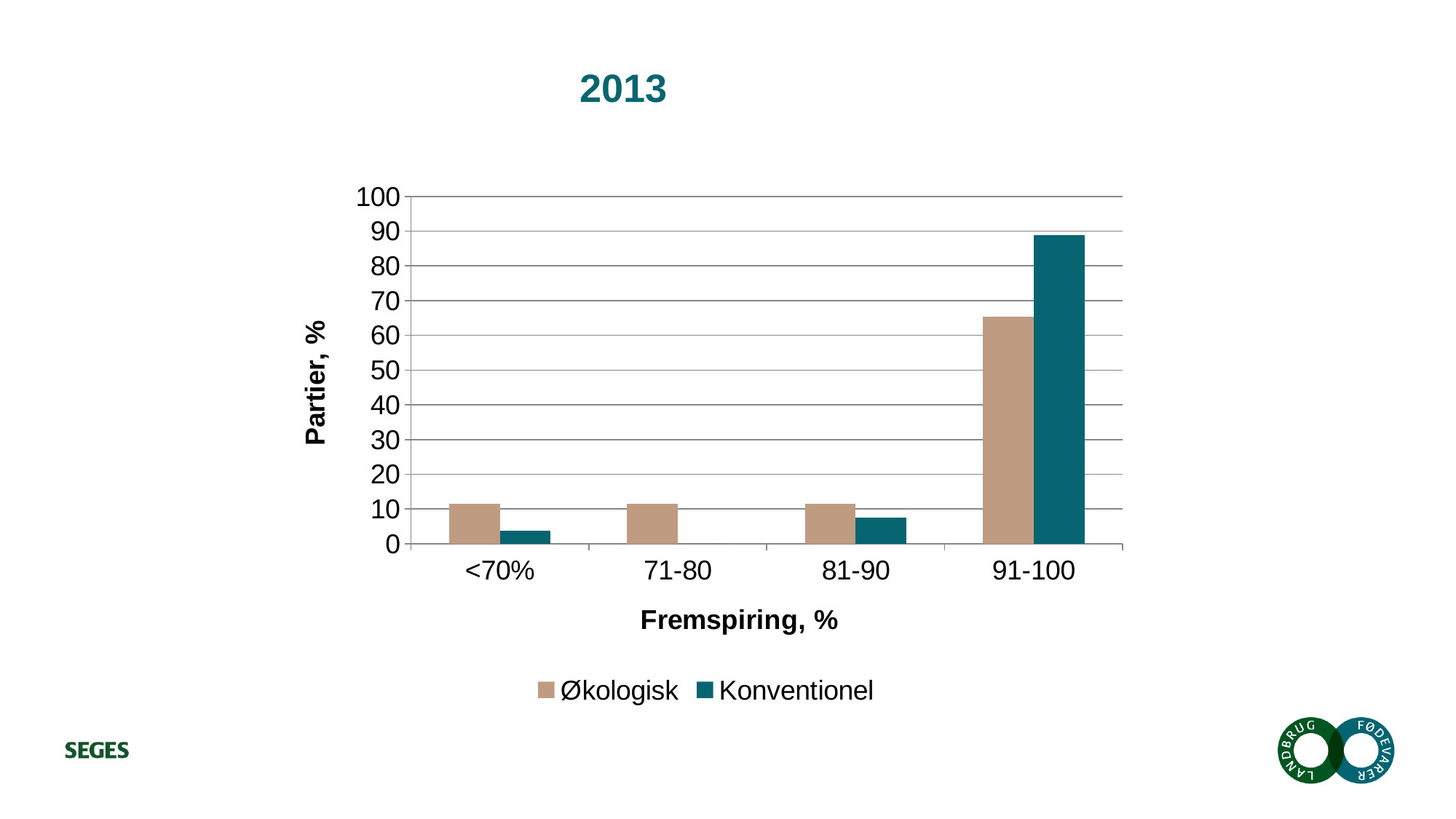
Which category has the highest value for Økologisk? 91-100 How many series does the legend list? 2 Is the value for Konventionel in the 91-100 category greater or less than 80? greater In the 91-100 category, which series has the larger value, Økologisk or Konventionel? Konventionel Which category has the lowest value for Konventionel? 71-80 Which category has the highest value for Konventionel? 91-100 What kind of chart is shown on the slide? bar chart Is the value for Økologisk in the 91-100 category greater or less than 70? less What is the label of the x axis? Fremspiring, % What is the title of the chart? 2013 In the <70% category, which series has the larger value, Økologisk or Konventionel? Økologisk How many categories are shown on the x axis? 4